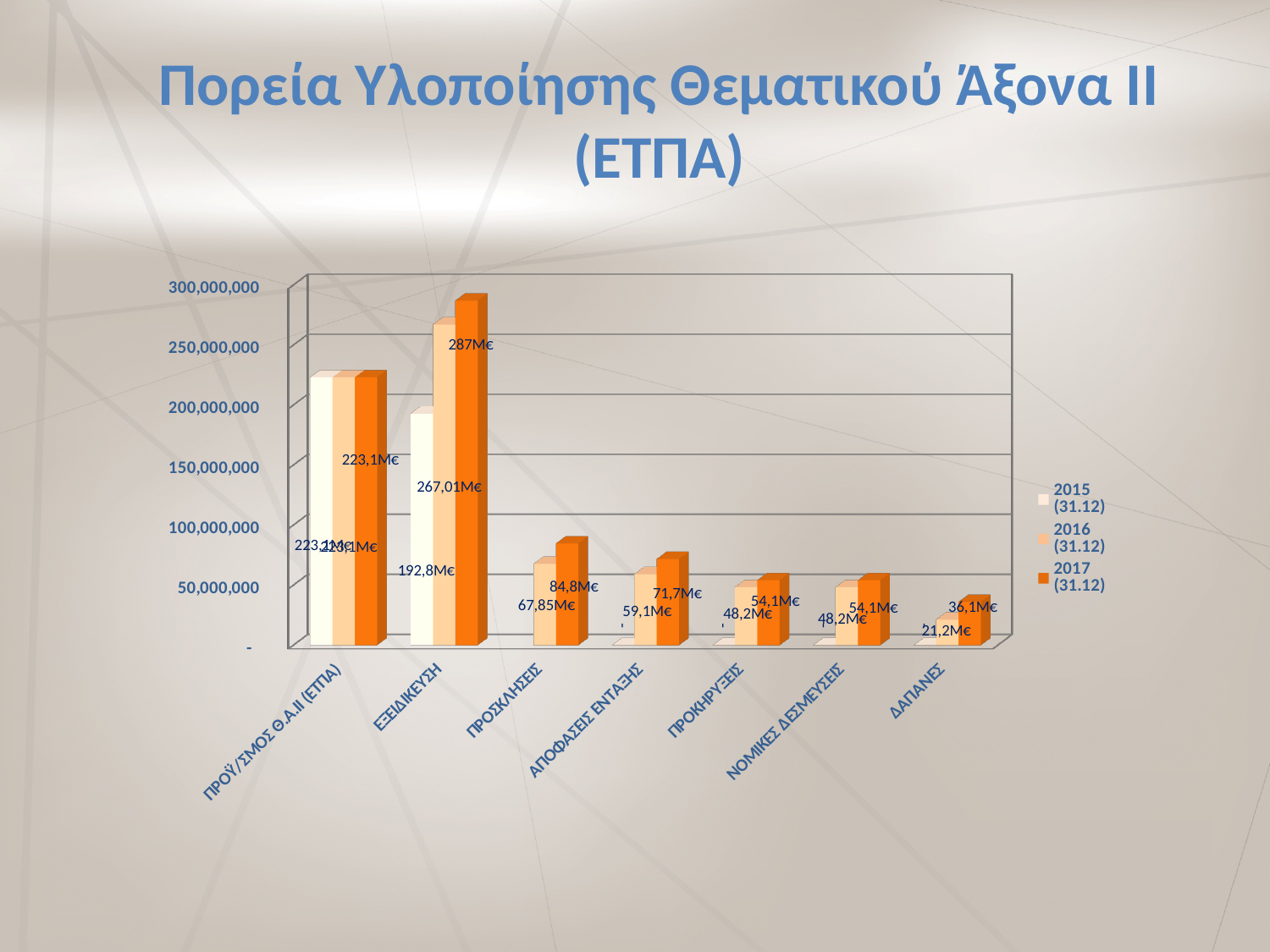
What is the value for ΕΞΕΙΔΙΚΕΥΣΗ in the 2015 (31.12) series? 192,8Μ€ How many categories are shown on the x axis? 7 What is the value for ΕΞΕΙΔΙΚΕΥΣΗ in the 2017 (31.12) series? 287Μ€ What is the difference between the 2017 (31.12) and 2016 (31.12) values for ΔΑΠΑΝΕΣ? 14,9Μ€ Is the 2017 (31.12) value for ΕΞΕΙΔΙΚΕΥΣΗ greater or less than 250,000,000? greater What is the value for ΔΑΠΑΝΕΣ in the 2016 (31.12) series? 21,2Μ€ What is the value for ΠΡΟΣΚΛΗΣΕΙΣ in the 2017 (31.12) series? 84,8Μ€ Which is larger for ΑΠΟΦΑΣΕΙΣ ΕΝΤΑΞΗΣ: the 2016 (31.12) value or the 2017 (31.12) value? 2017 (31.12) Which category has the lowest value in the 2017 (31.12) series? ΔΑΠΑΝΕΣ What type of chart is shown on the slide? Bar chart How many series does the legend list? 3 Which category has the highest value in the 2017 (31.12) series? ΕΞΕΙΔΙΚΕΥΣΗ